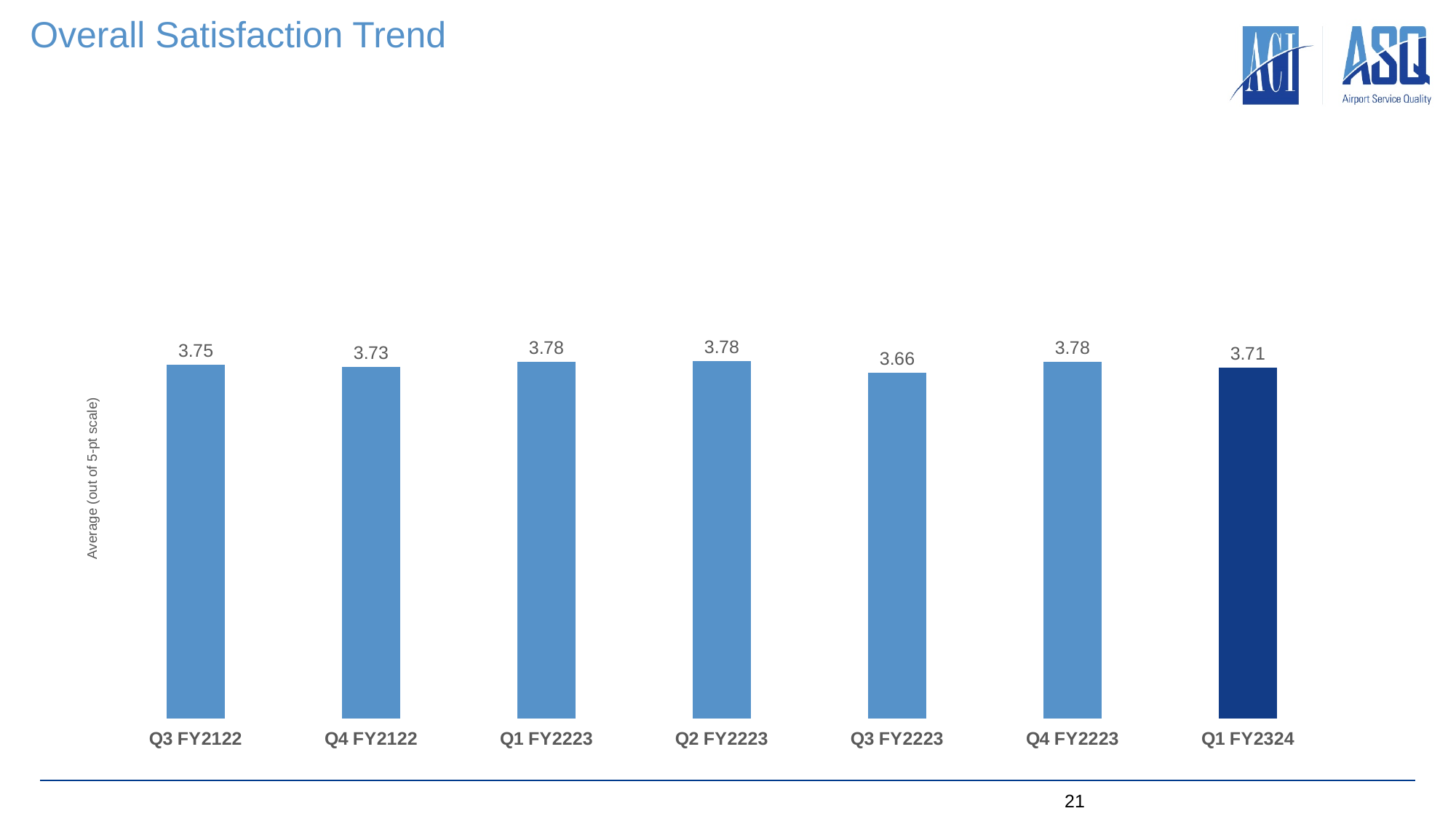
What is the highest average satisfaction score shown on the chart? 3.78 Which is larger, the score for Q4 FY2122 or the score for Q1 FY2324? Q4 FY2122 Which quarter has the lowest average satisfaction score? Q3 FY2223 What is the average satisfaction score for Q1 FY2324? 3.71 What is the average satisfaction score for Q3 FY2223? 3.66 What is the difference between the scores for Q4 FY2223 and Q1 FY2324? 0.07 What kind of chart is shown on the slide? Bar chart What is the average satisfaction score for Q4 FY2122? 3.73 How many quarters are shown on the chart? 7 What is the average satisfaction score for Q3 FY2122? 3.75 What is the difference between the scores for Q3 FY2122 and Q3 FY2223? 0.09 What is the label of the vertical axis? Average (out of 5-pt scale)